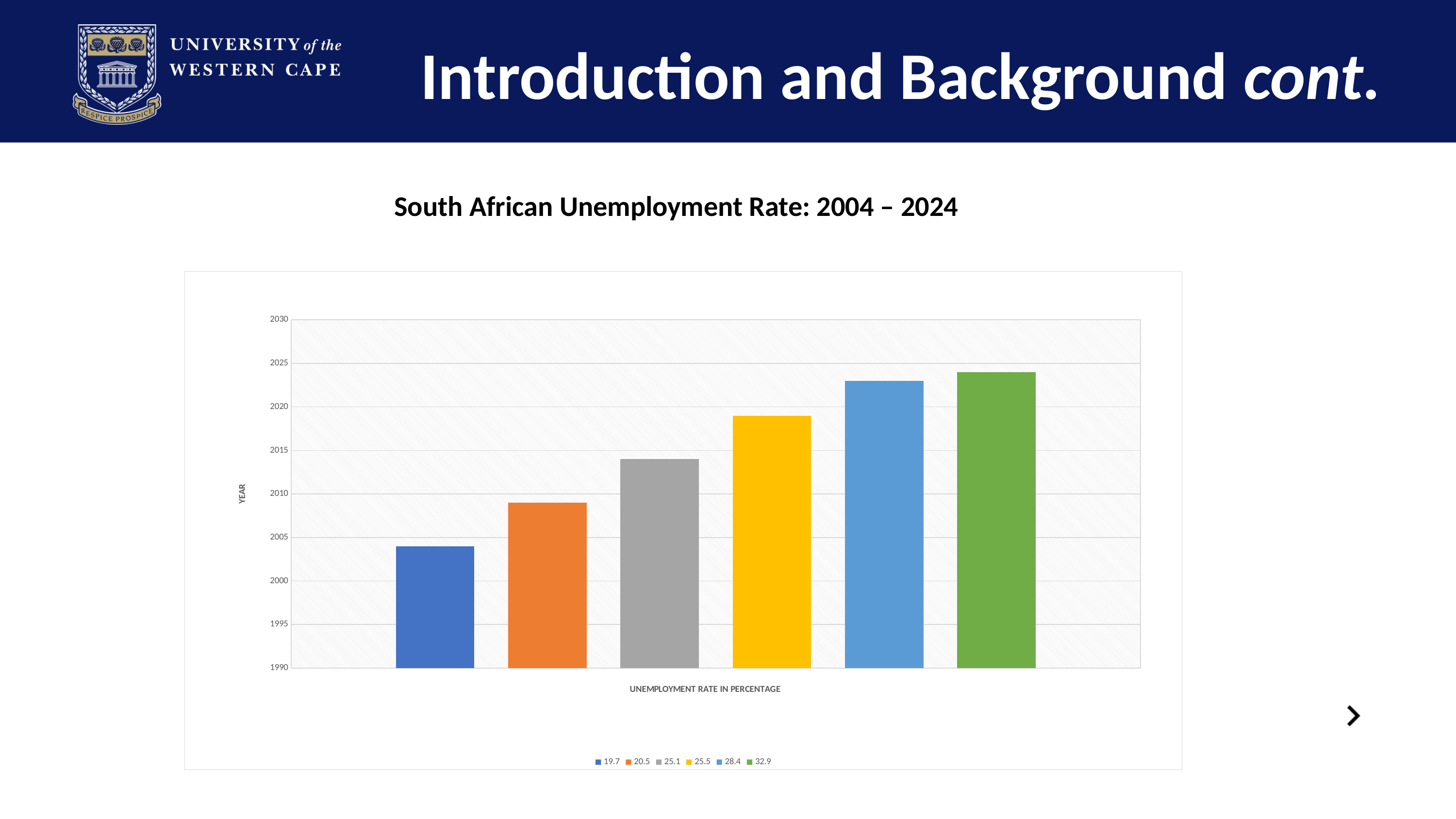
How many bars are plotted in the chart? 6 Which legend series has the shortest bar in the chart? 19.7 What kind of chart is shown on the slide? bar chart How many series does the chart legend list? 6 Do the bar heights rise or fall from left to right across the chart? rise Which bar is taller, the one for the 32.9 series or the one for the 25.1 series? 32.9 Is the bar for the 28.4 series greater or less than 2020 on the vertical axis? greater What label is shown on the vertical axis of the chart? YEAR What is the title of the chart on the slide? South African Unemployment Rate: 2004 – 2024 Is the bar for the 19.7 series greater or less than 2000 on the vertical axis? greater Which legend series has the tallest bar in the chart? 32.9